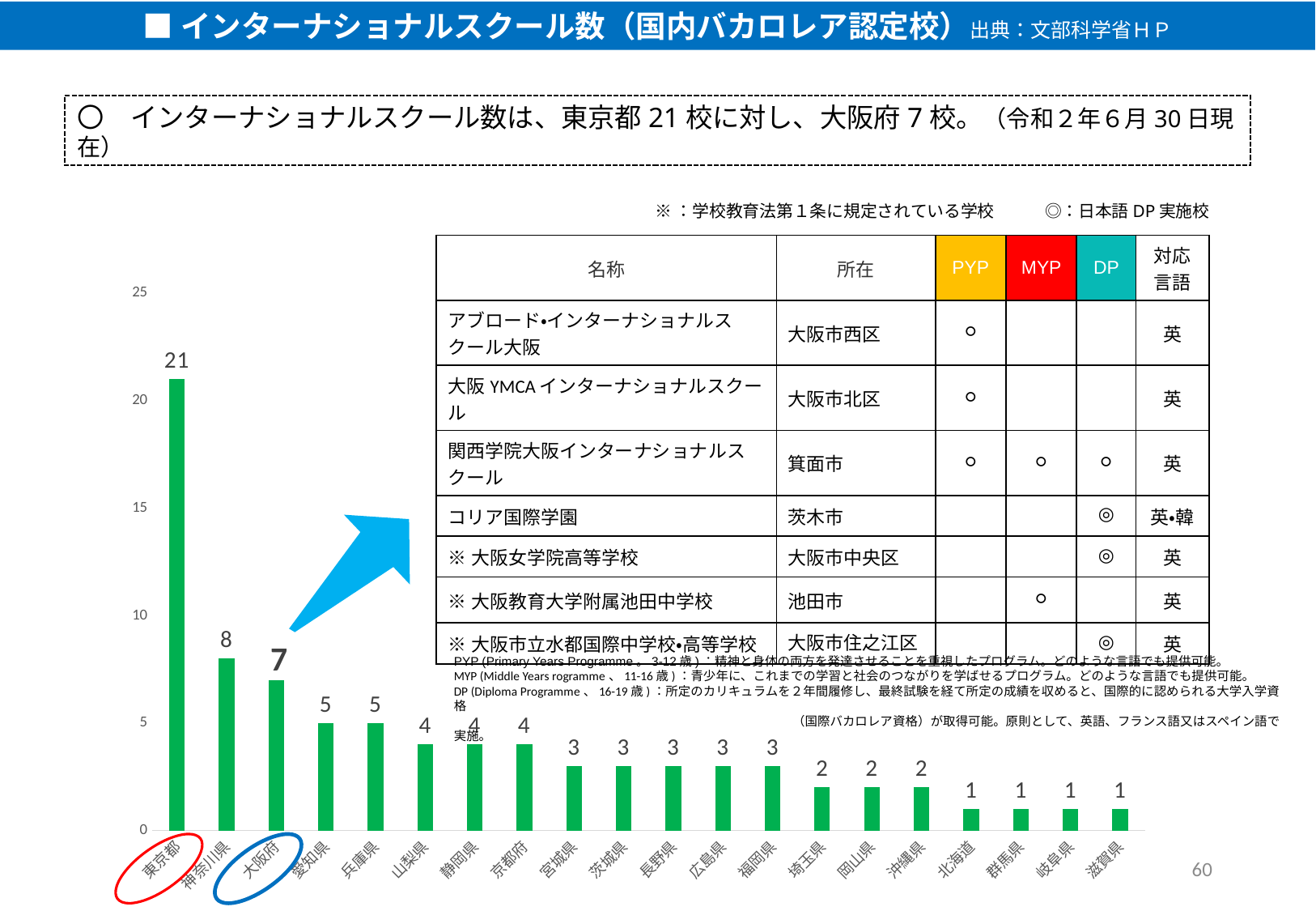
What is the value for 大阪府 in the bar chart? 7 Is the value for 東京都 greater or less than 20? greater What is the difference between the values for 東京都 and 大阪府? 14 Which is larger, the value for 神奈川県 or the value for 大阪府? 神奈川県 What is the difference between the values for 神奈川県 and 愛知県? 3 Do the values rise or fall from left to right along the x axis of the bar chart? fall What is the value for 東京都 in the bar chart? 21 What is the value for 神奈川県 in the bar chart? 8 What kind of chart is shown on the slide? bar chart How many categories are shown in the bar chart? 20 What is the value for 福岡県 in the bar chart? 3 Which category has the highest value in the bar chart? 東京都